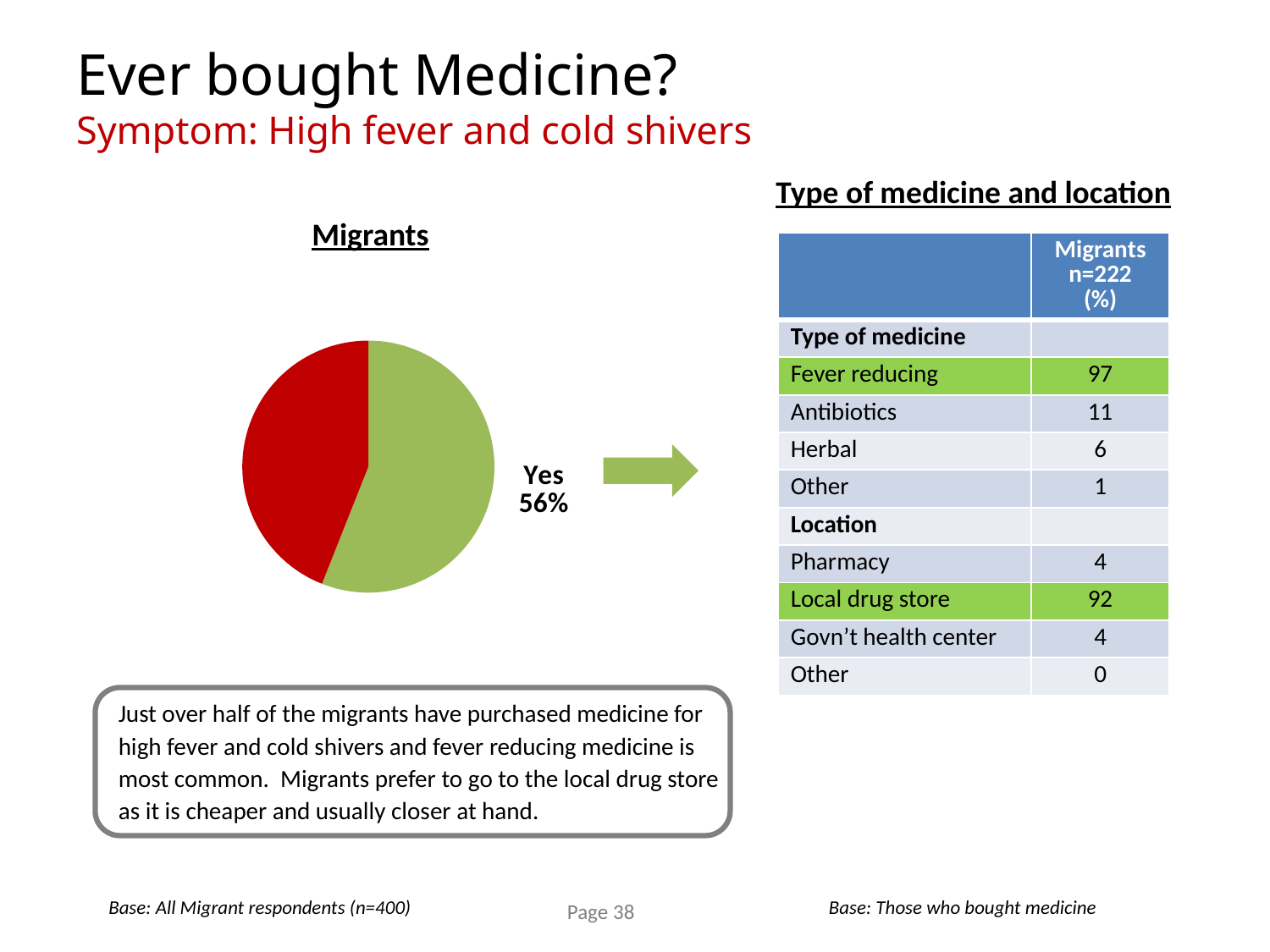
In the 'Migrants' pie chart, what share of migrants answered 'Yes'? 56% In the 'Migrants' pie chart, which slice is the largest? Yes What is the title of the pie chart on the slide? Migrants In the 'Migrants' pie chart, is the red slice greater or less than 50%? less How many slices does the 'Migrants' pie chart have? 2 What kind of chart is shown under the heading 'Migrants'? pie chart In the 'Migrants' pie chart, is the 'Yes' share greater or less than 50%? greater In the 'Migrants' pie chart, which slice is larger, the green 'Yes' slice or the red slice? the green 'Yes' slice What colour is the 'Yes' slice in the 'Migrants' pie chart? green